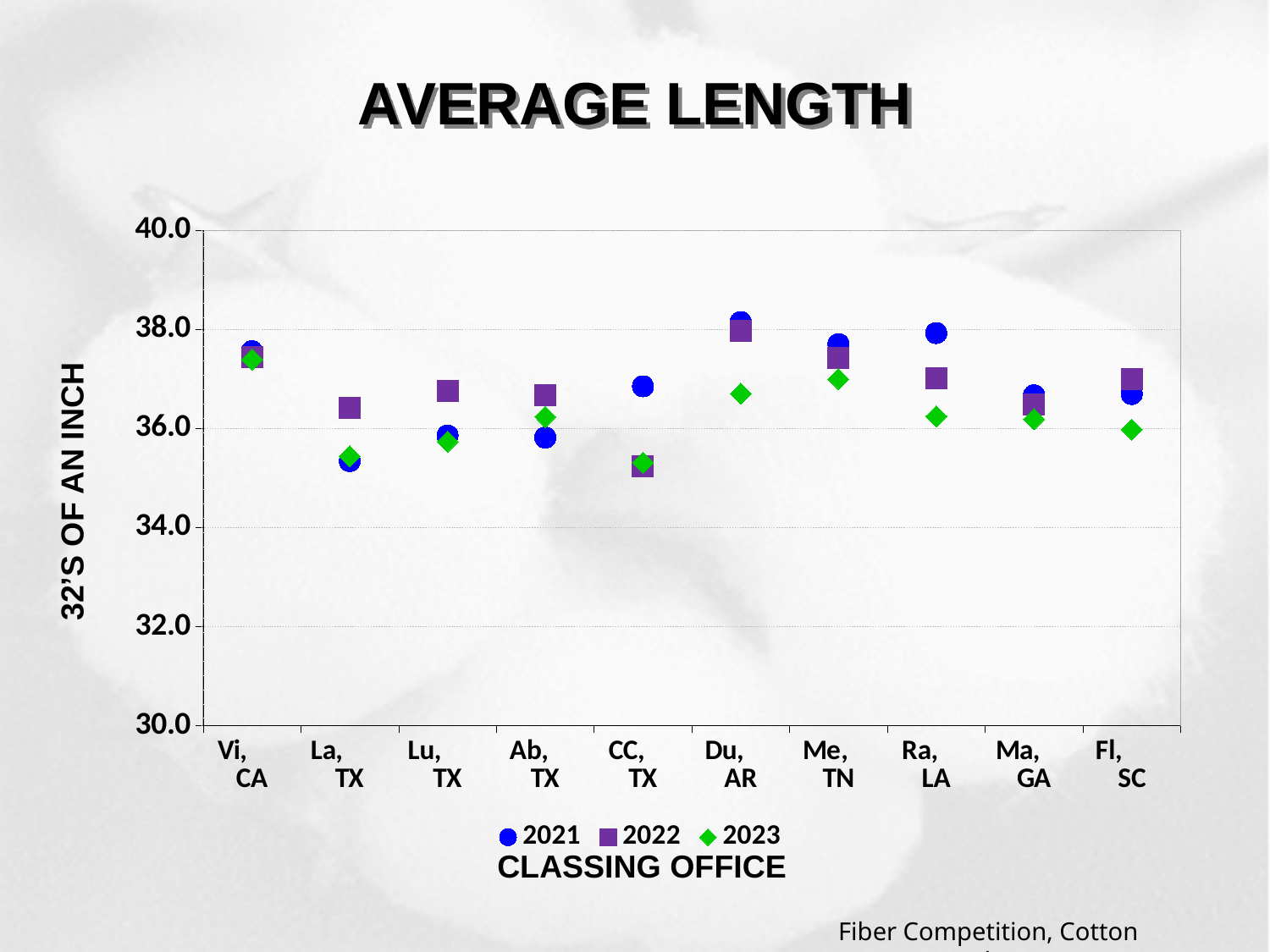
How many classing offices are shown on the x axis? 10 Which classing office has the lowest 2021 value? La, TX Is the 2021 value for Ra, LA greater or less than 36.0? greater How many series does the legend list? 3 Is the 2023 value for CC, TX greater or less than 36.0? less What is the title of the y axis? 32'S OF AN INCH What kind of chart is shown on the slide? Scatter chart Which classing office has the highest 2023 value? Vi, CA Which classing office has the lowest 2022 value? CC, TX Which classing office has the highest 2022 value? Du, AR At CC, TX, which is larger: the 2021 value or the 2022 value? 2021 Which classing office has the highest 2021 value? Du, AR